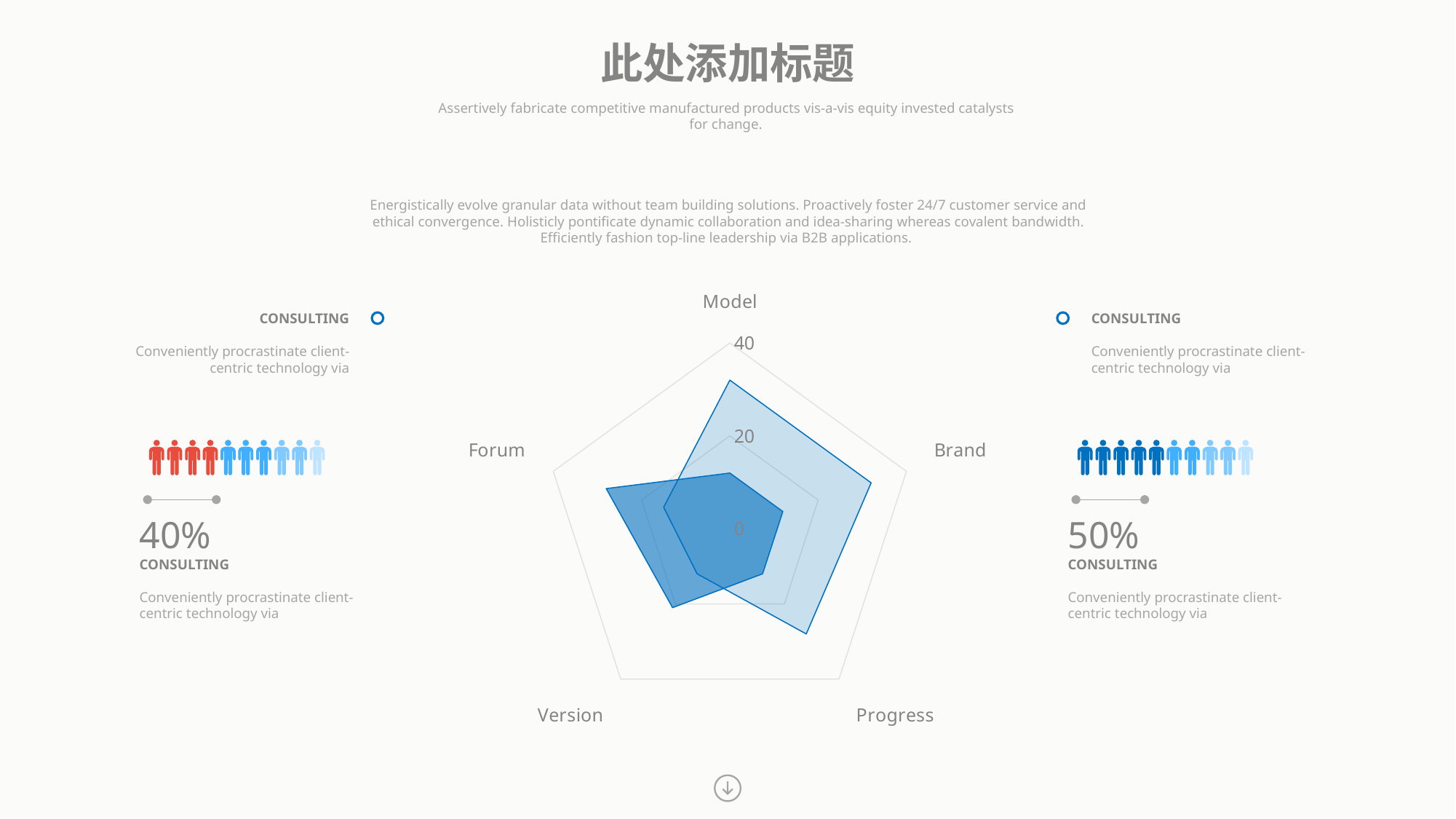
How many categories (axes) does the radar chart have? 5 Which category label appears at the top of the radar chart? Model Is the value for Brand in the lighter blue series greater or less than 20? greater Is the value for Model in the lighter blue series greater or less than 20? greater Is the value for Forum in the lighter blue series greater or less than 20? less What is the highest value shown on the radar chart's axis scale? 40 Which series has the larger value for Brand, the lighter blue series or the darker blue series? the lighter blue series What kind of chart is shown on the slide? radar chart